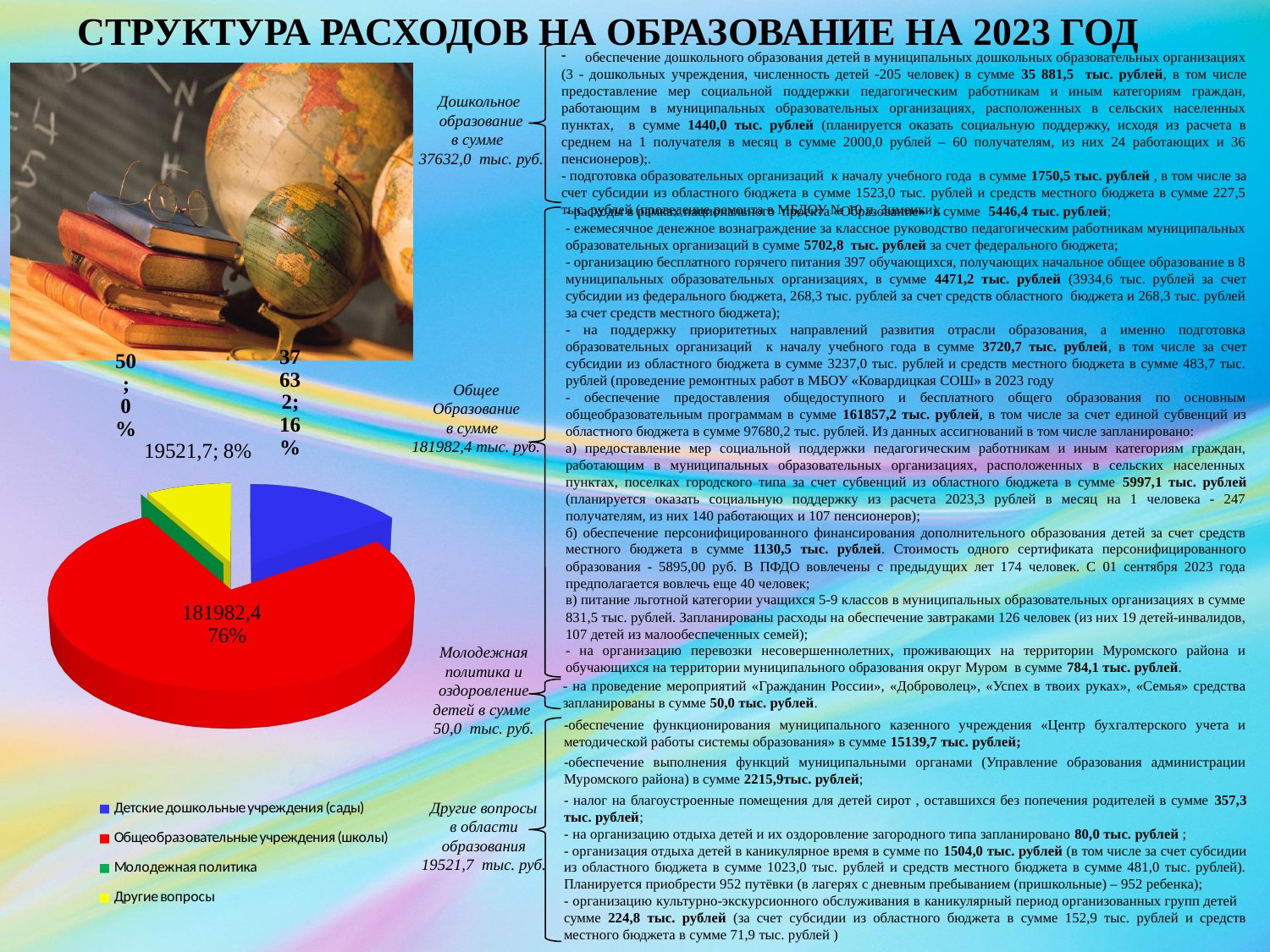
What share of the pie does Общеобразовательные учреждения (школы) have? 76% What value is labelled on the slice for Другие вопросы? 19521,7 How many categories does the pie chart have? 4 What value is labelled on the slice for Общеобразовательные учреждения (школы)? 181982,4 Which category has the largest slice of the pie chart? Общеобразовательные учреждения (школы) What colour is the slice for Общеобразовательные учреждения (школы)? red Which is larger: the slice for Детские дошкольные учреждения (сады) or the slice for Другие вопросы? Детские дошкольные учреждения (сады) What kind of chart is shown on the slide? pie chart What share of the pie does Детские дошкольные учреждения (сады) have? 16% Which category has the smallest slice of the pie chart? Молодежная политика What is the difference between the values for Общеобразовательные учреждения (школы) and Другие вопросы? 162460,7 What share of the pie does Другие вопросы have? 8%